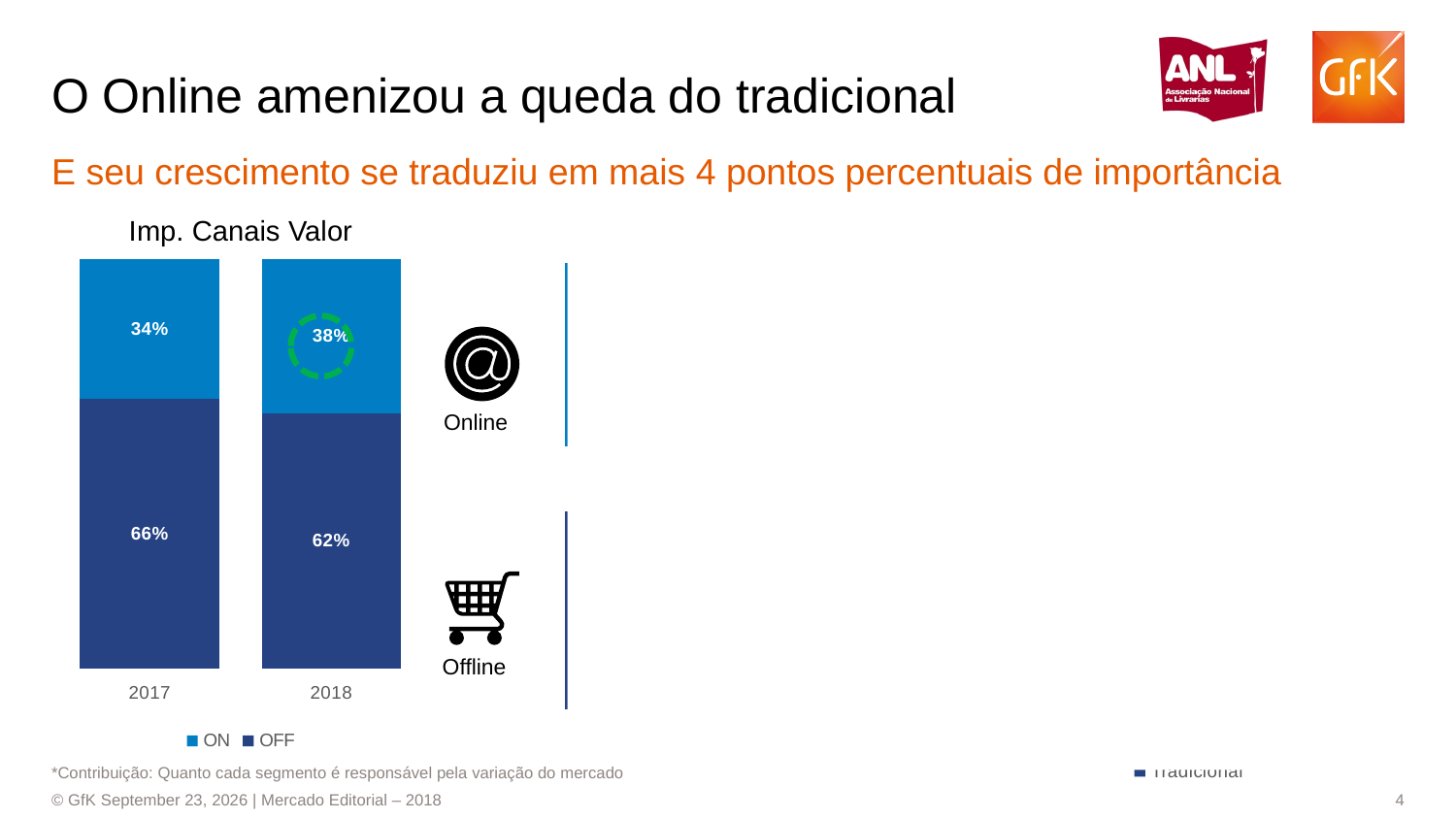
What is the value of the OFF series for 2017 in the 'Imp. Canais Valor' chart? 66% What is the value of the ON series for 2018 in the 'Imp. Canais Valor' chart? 38% What is the value of the OFF series for 2018 in the 'Imp. Canais Valor' chart? 62% In which year is the OFF share lower in the 'Imp. Canais Valor' chart? 2018 What is the value of the ON series for 2017 in the 'Imp. Canais Valor' chart? 34% By how many percentage points did the ON share increase from 2017 to 2018 in the 'Imp. Canais Valor' chart? 4 In which year is the ON share higher in the 'Imp. Canais Valor' chart? 2018 How many series does the legend of the 'Imp. Canais Valor' chart list? 2 How many years are shown on the x axis of the 'Imp. Canais Valor' chart? 2 What kind of chart is 'Imp. Canais Valor'? Stacked bar chart Which is larger in 2018 in the 'Imp. Canais Valor' chart: the ON share or the OFF share? OFF Does the OFF share rise or fall from 2017 to 2018 in the 'Imp. Canais Valor' chart? Fall